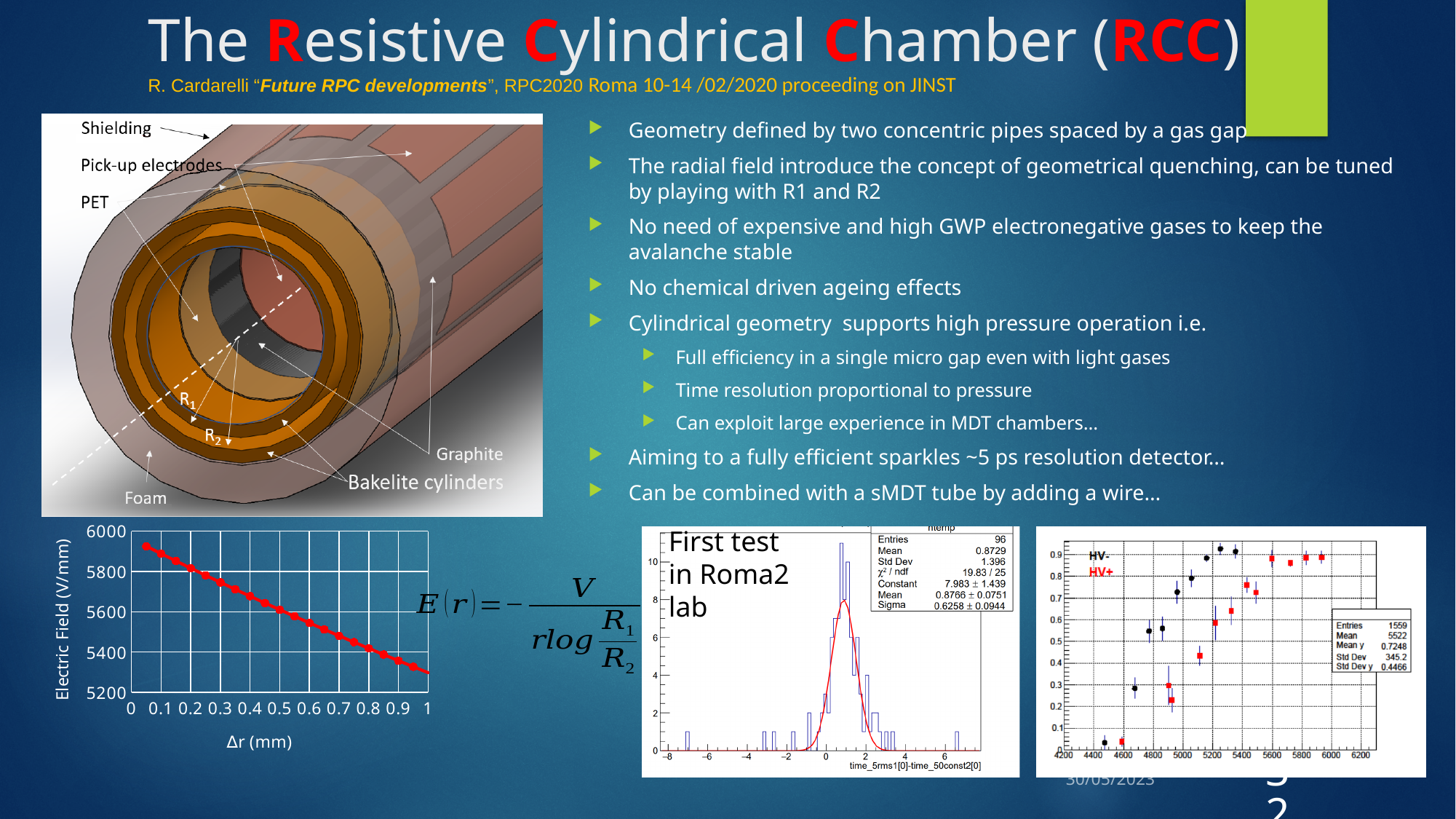
In the bottom-left chart, what is the label of the y axis? Electric Field (V/mm) In the right-hand scatter plot, at an x value of 5000, which series has the larger value, HV- or HV+? HV- In the bottom-left chart, is the electric field at Δr = 0.9 mm greater or less than 5400? less In the right-hand scatter plot, how many series does the legend list? 2 In the bottom-left chart, what is the maximum value shown on the y axis? 6000 In the middle histogram, what is the Std Dev listed in the statistics box? 1.396 In the bottom-left chart of Electric Field versus Δr, do the values rise or fall as Δr increases? fall In the bottom-left chart, is the electric field at Δr = 0.1 mm greater or less than 5800? greater In the middle histogram, what is the Sigma of the fit given in the statistics box? 0.6258 ± 0.0944 In the right-hand scatter plot, do the HV+ values rise or fall as the x value increases? rise In the middle histogram (First test in Roma2 lab), how many entries are listed in the statistics box? 96 In the right-hand scatter plot, what is the Mean y value given in the statistics box? 0.7248